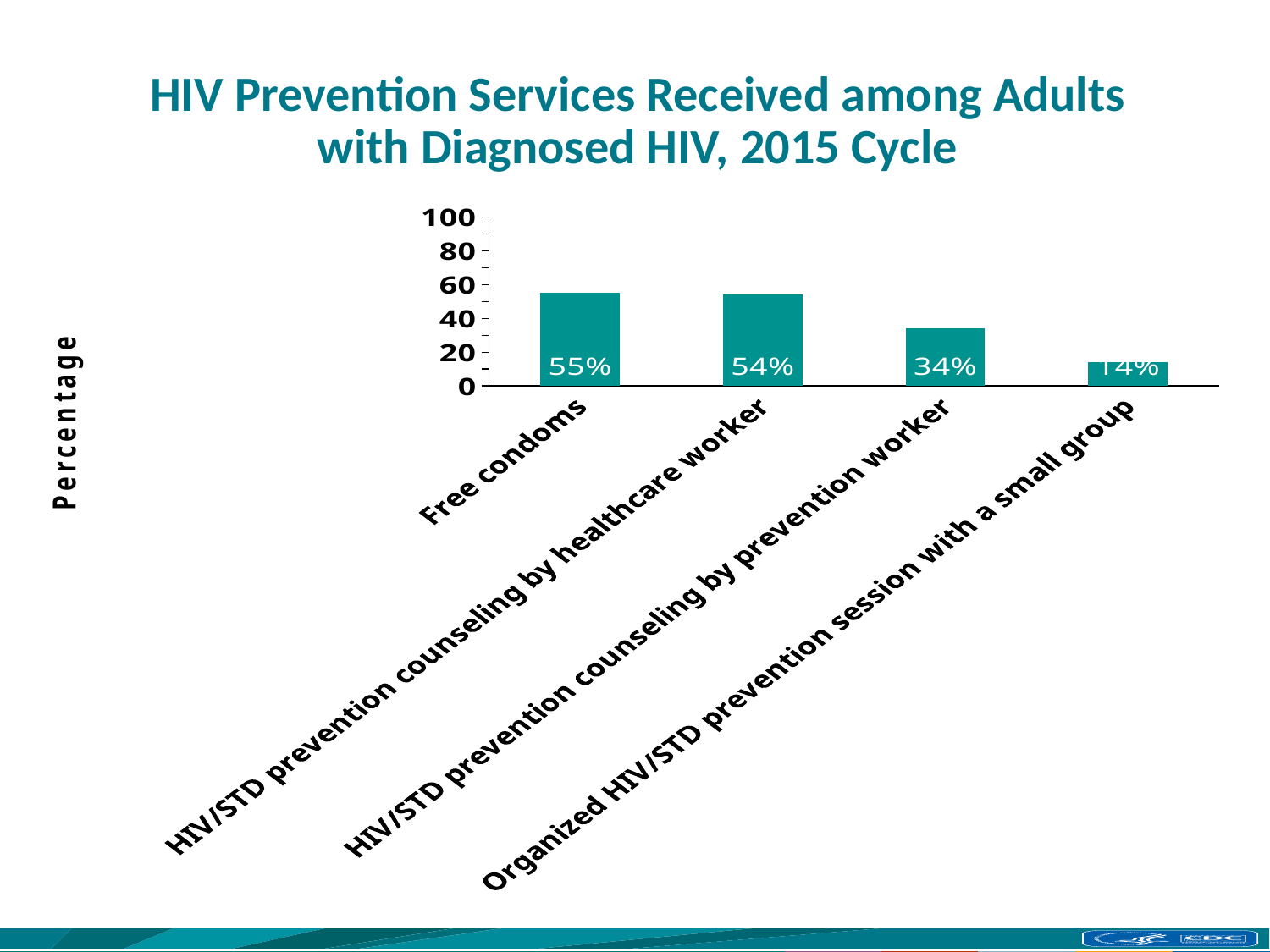
What is the value for HIV/STD prevention counseling by healthcare worker? 54% What is the label of the vertical axis? Percentage What is the difference between the percentage for free condoms and the percentage for HIV/STD prevention counseling by prevention worker? 21% What is the value for Organized HIV/STD prevention session with a small group? 14% Which service has the lowest percentage? Organized HIV/STD prevention session with a small group Which service has the highest percentage? Free condoms What type of chart is shown on the slide? Bar chart Which is larger: the value for HIV/STD prevention counseling by prevention worker or the value for Organized HIV/STD prevention session with a small group? HIV/STD prevention counseling by prevention worker What is the difference between HIV/STD prevention counseling by healthcare worker and Organized HIV/STD prevention session with a small group? 40% What percentage of adults received free condoms? 55% How many service categories are shown in the chart? 4 What is the value for HIV/STD prevention counseling by prevention worker? 34%